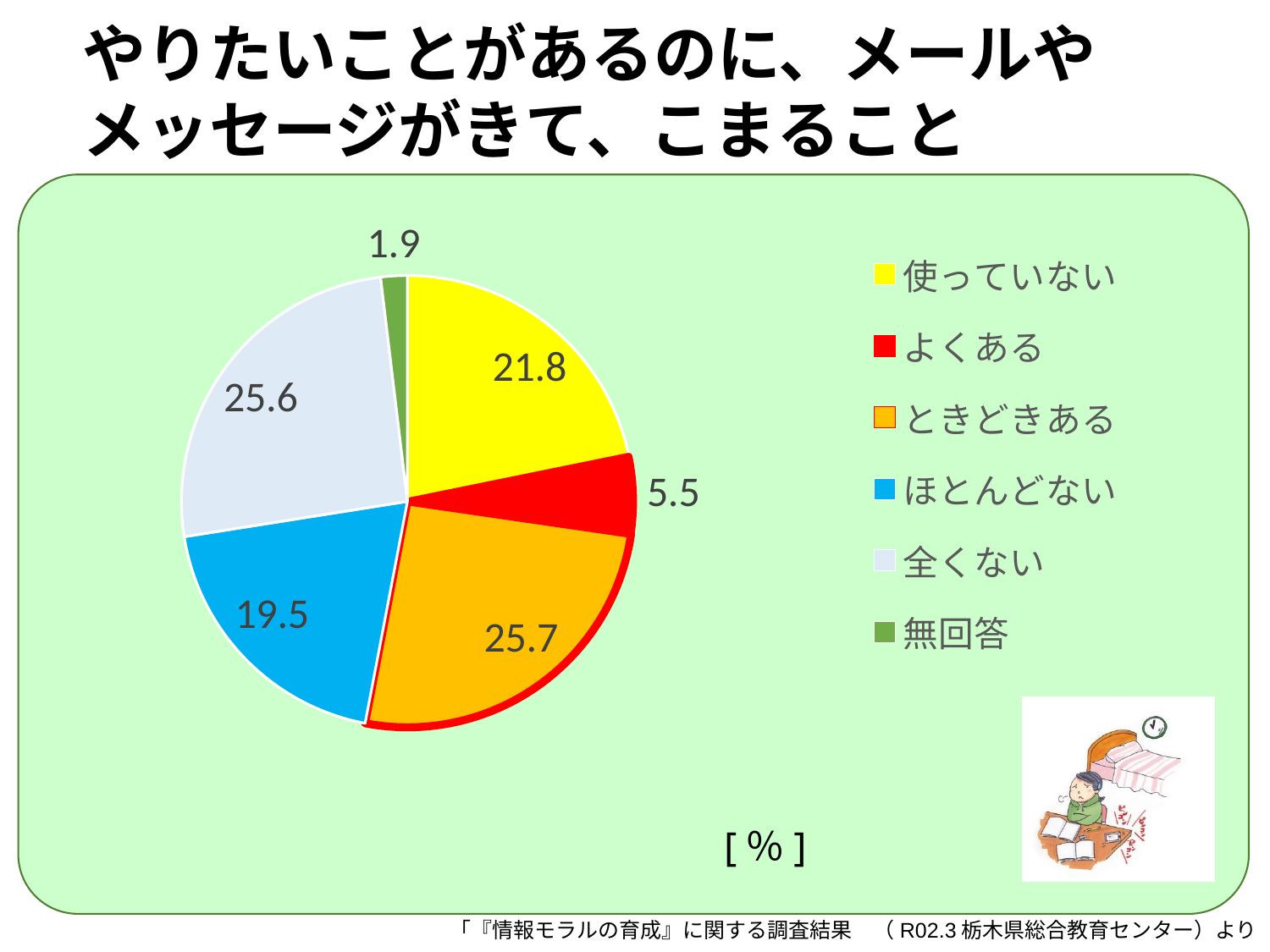
What is the difference between the values for ときどきある and よくある? 20.2 Which is larger, 使っていない or ほとんどない? 使っていない What colour is the slice for 無回答? green What is the value for 全くない? 25.6 What is the value for ほとんどない? 19.5 Which category has the smallest slice? 無回答 What unit is shown for the values in the chart? % What is the value for よくある? 5.5 What is the value for 使っていない? 21.8 What is the value for ときどきある? 25.7 How many categories does the pie chart have? 6 What type of chart is shown on the slide? pie chart